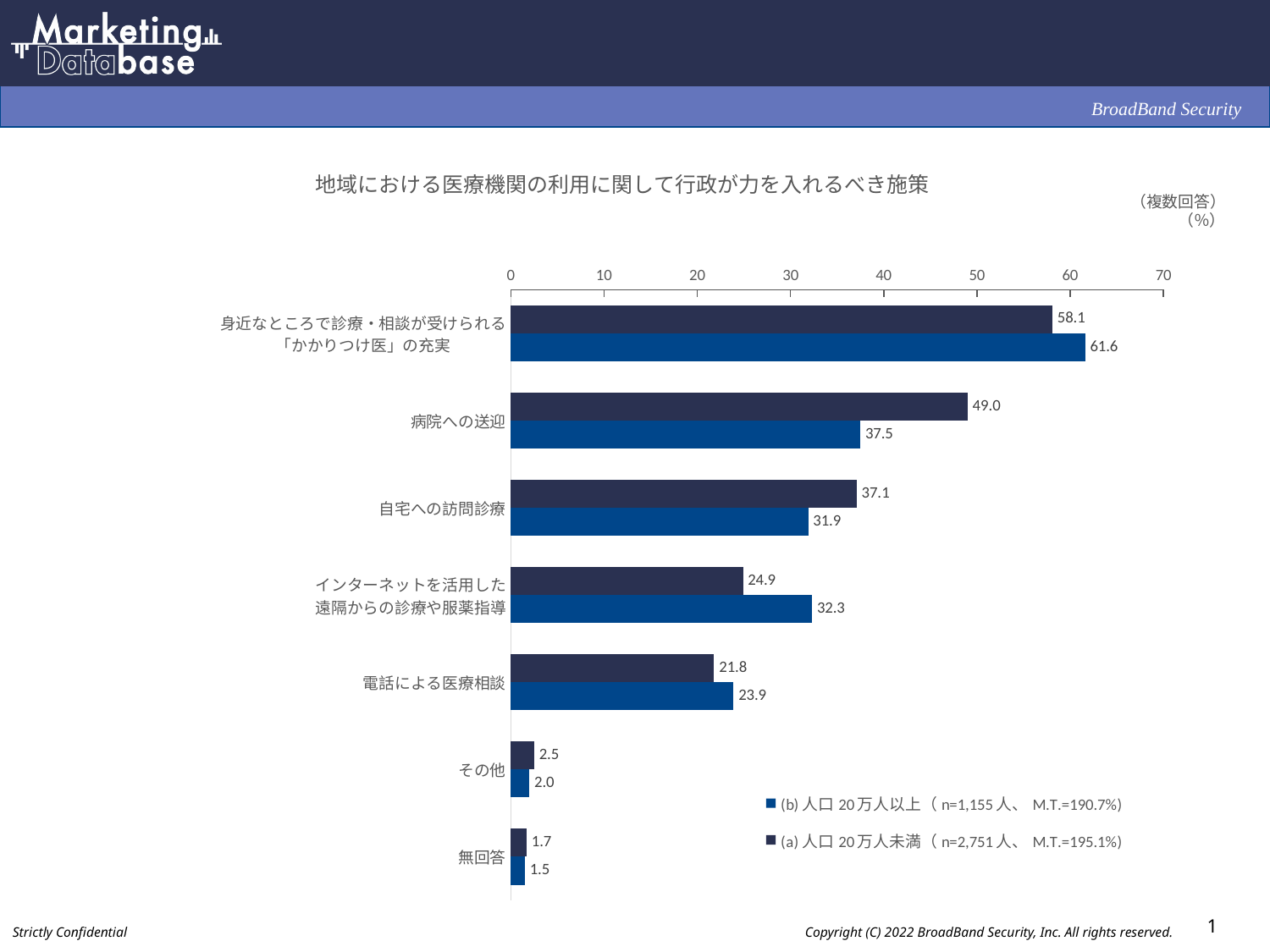
How many series does the legend list? 2 What is the title of the chart? 地域における医療機関の利用に関して行政が力を入れるべき施策 How many categories are plotted on the chart? 7 What is the value for インターネットを活用した遠隔からの診療や服薬指導 in the (b) 人口20万人以上 series? 32.3 Which category has the lowest value in the (b) 人口20万人以上 series? 無回答 Which category has the highest value in the (a) 人口20万人未満 series? 身近なところで診療・相談が受けられる「かかりつけ医」の充実 What is the value for 病院への送迎 in the (a) 人口20万人未満 series? 49.0 For 電話による医療相談, which series has the larger value, (a) 人口20万人未満 or (b) 人口20万人以上? (b) 人口20万人以上 What kind of chart is shown on the slide? bar chart What is the difference between the (a) and (b) values for 病院への送迎? 11.5 What is the value for 身近なところで診療・相談が受けられる「かかりつけ医」の充実 in the (b) 人口20万人以上 series? 61.6 Is the value for 自宅への訪問診療 in the (a) 人口20万人未満 series greater or less than 30? greater